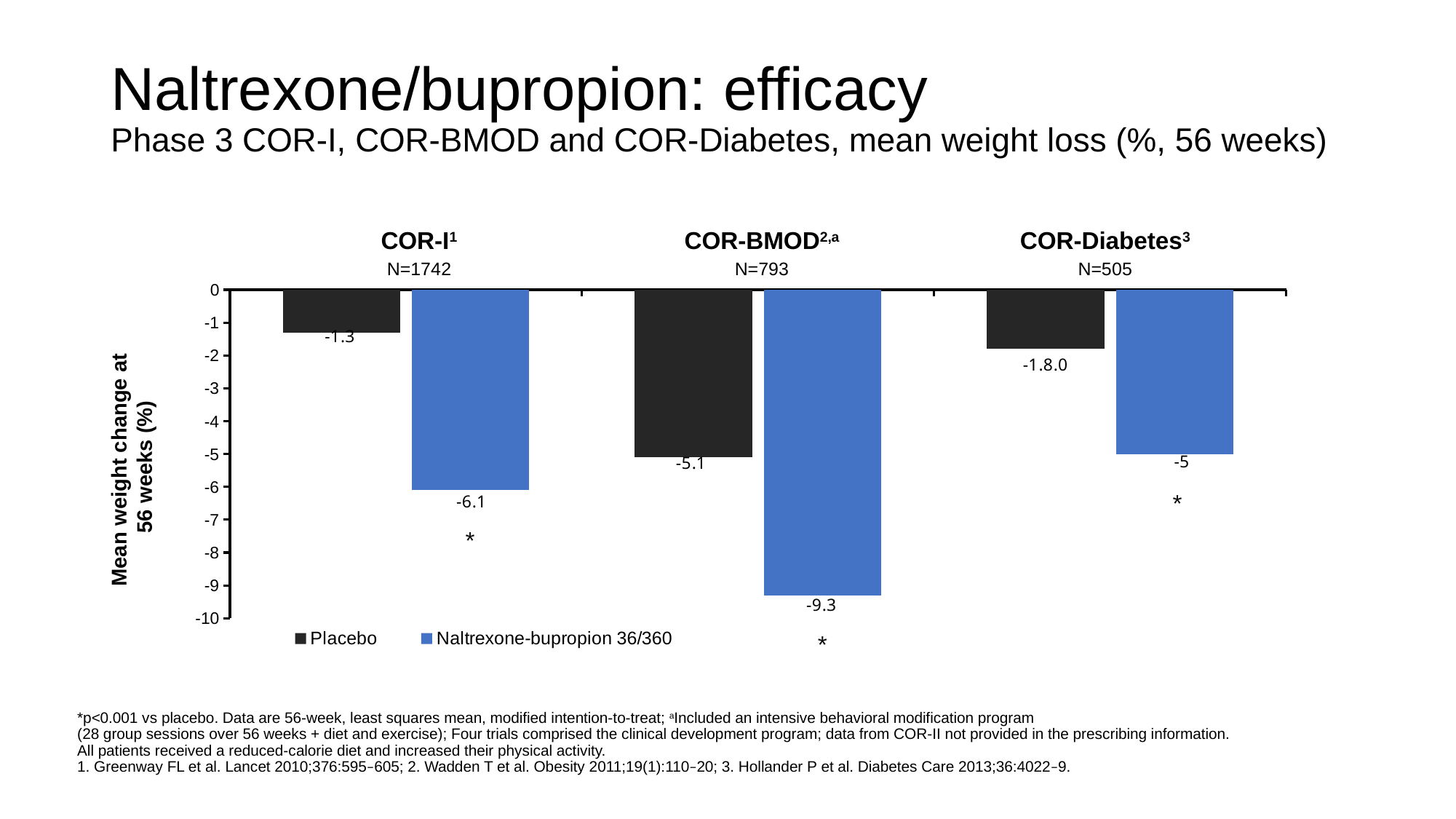
What is the mean weight change for Placebo in COR-I? -1.3 What is the mean weight change for Naltrexone-bupropion 36/360 in COR-Diabetes? -5 In COR-I, how many percentage points greater is the weight loss with Naltrexone-bupropion 36/360 than with Placebo? 4.8 How many series does the legend list? 2 What kind of chart is shown on the slide? Bar chart In which trial does Naltrexone-bupropion 36/360 show the largest mean weight loss? COR-BMOD What is the mean weight change for Placebo in COR-BMOD? -5.1 What is the N shown for the COR-BMOD trial? N=793 What is the mean weight change for Naltrexone-bupropion 36/360 in COR-I? -6.1 What is the mean weight change for Naltrexone-bupropion 36/360 in COR-BMOD? -9.3 How many trials are shown on the x axis of the chart? 3 Which trial has the larger placebo weight loss, COR-I or COR-BMOD? COR-BMOD